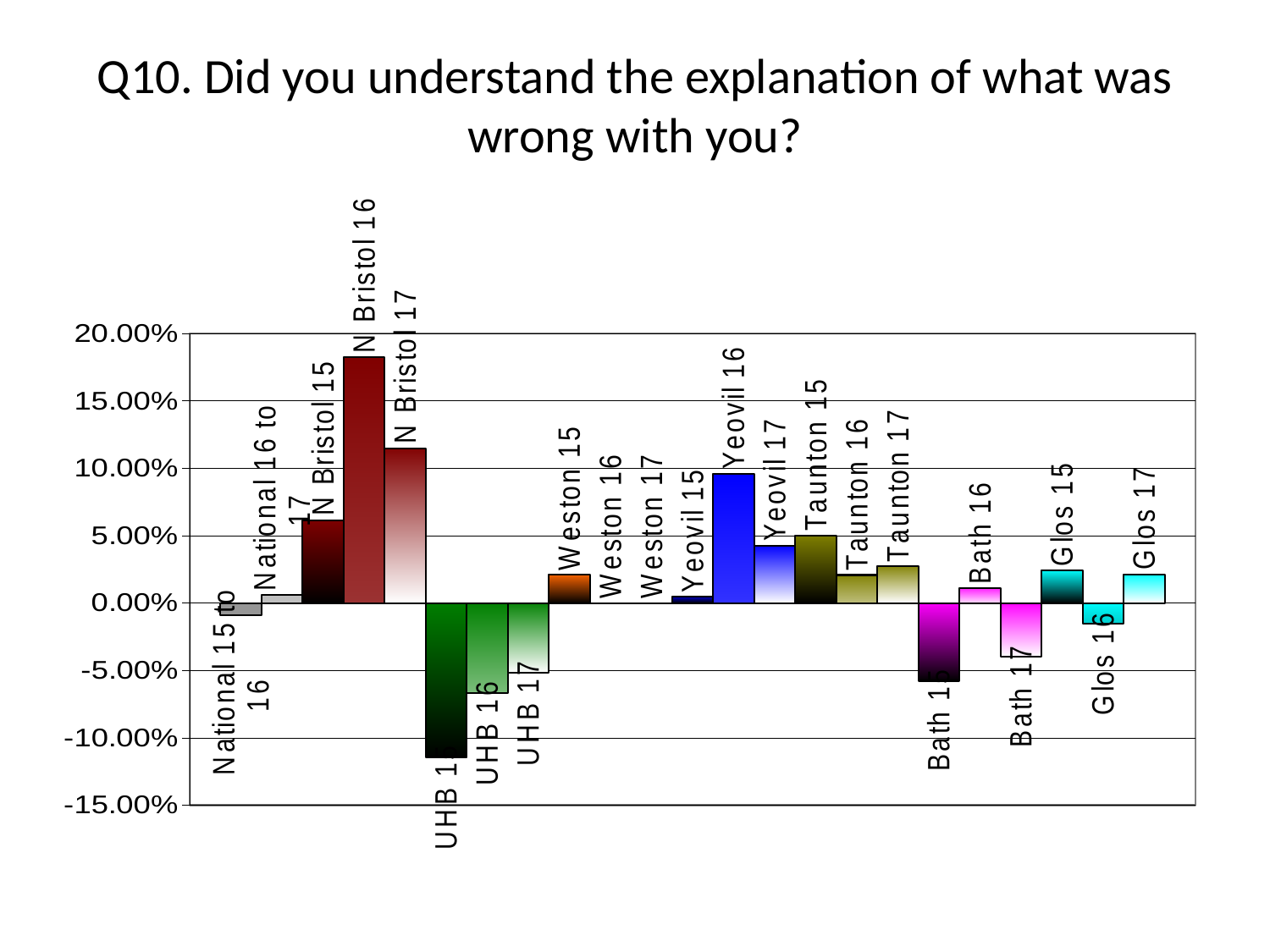
Is the value for N Bristol 16 greater or less than 15.00%? greater Which is larger, the value for N Bristol 16 or N Bristol 17? N Bristol 16 Is the value for Bath 17 greater or less than 0.00%? less What kind of chart is shown on the slide? bar chart What is the title of the chart? Q10. Did you understand the explanation of what was wrong with you? Which category has the highest value in the chart? N Bristol 16 Which is larger, the value for Glos 15 or Glos 16? Glos 15 Is the value for UHB 16 greater or less than -5.00%? less Which is larger, the value for Yeovil 16 or Yeovil 17? Yeovil 16 What is the highest value shown on the vertical axis? 20.00%